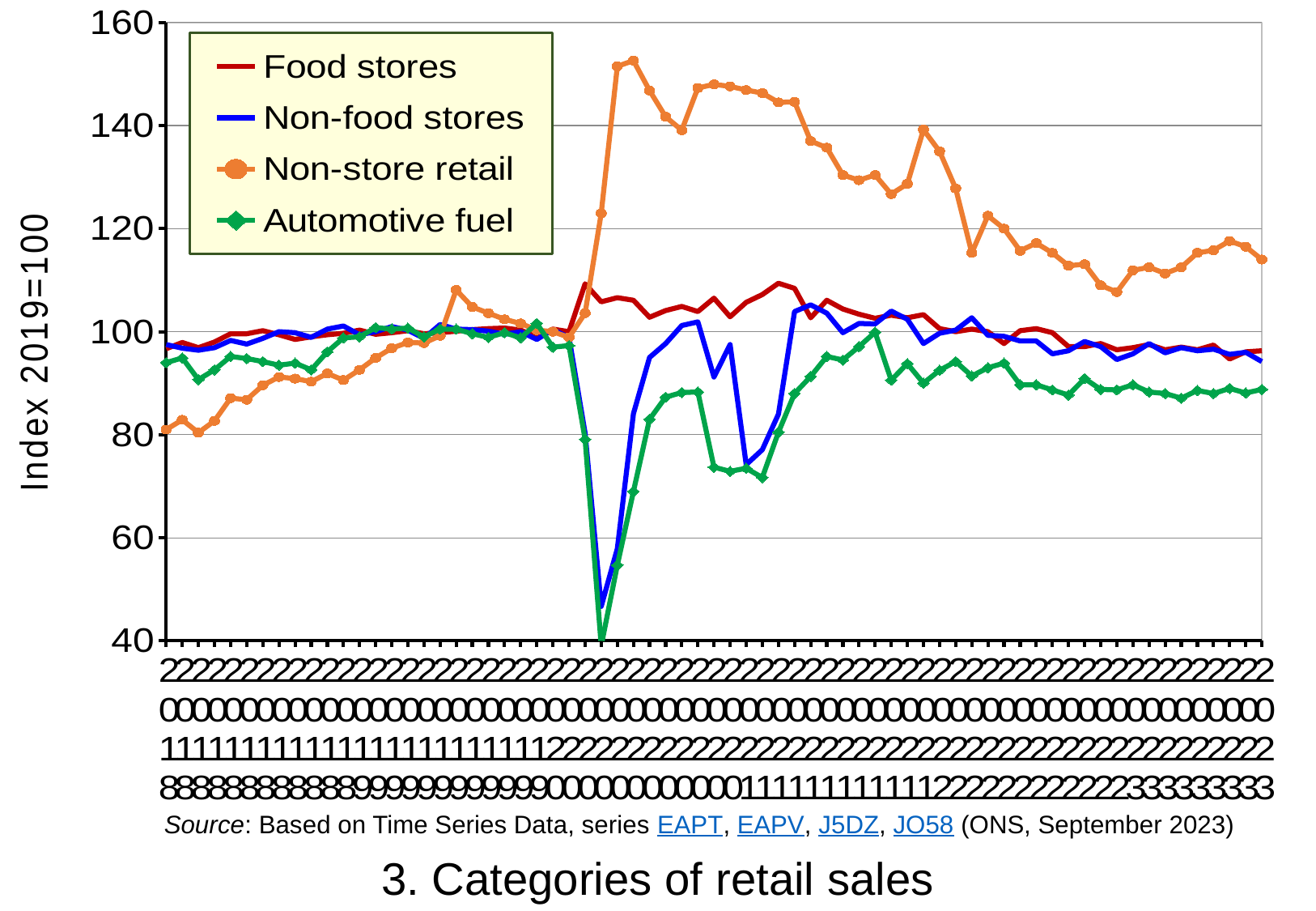
Is the peak value of the Non-store retail series greater or less than 140? greater Which series reaches the highest value anywhere on the chart? Non-store retail What kind of chart is shown on the slide? Line chart At the sharp dip in 2020, which series drops lower: Non-food stores or Automotive fuel? Automotive fuel Is the lowest value of the Non-food stores series greater or less than 60? less Which series falls to the lowest value anywhere on the chart? Automotive fuel What is the label on the vertical axis? Index 2019=100 Is the lowest value of the Food stores series greater or less than 80? greater What is the title of the chart? 3. Categories of retail sales Comparing the start and end of the x axis, does the Non-store retail series rise or fall overall? rise How many series does the legend list? 4